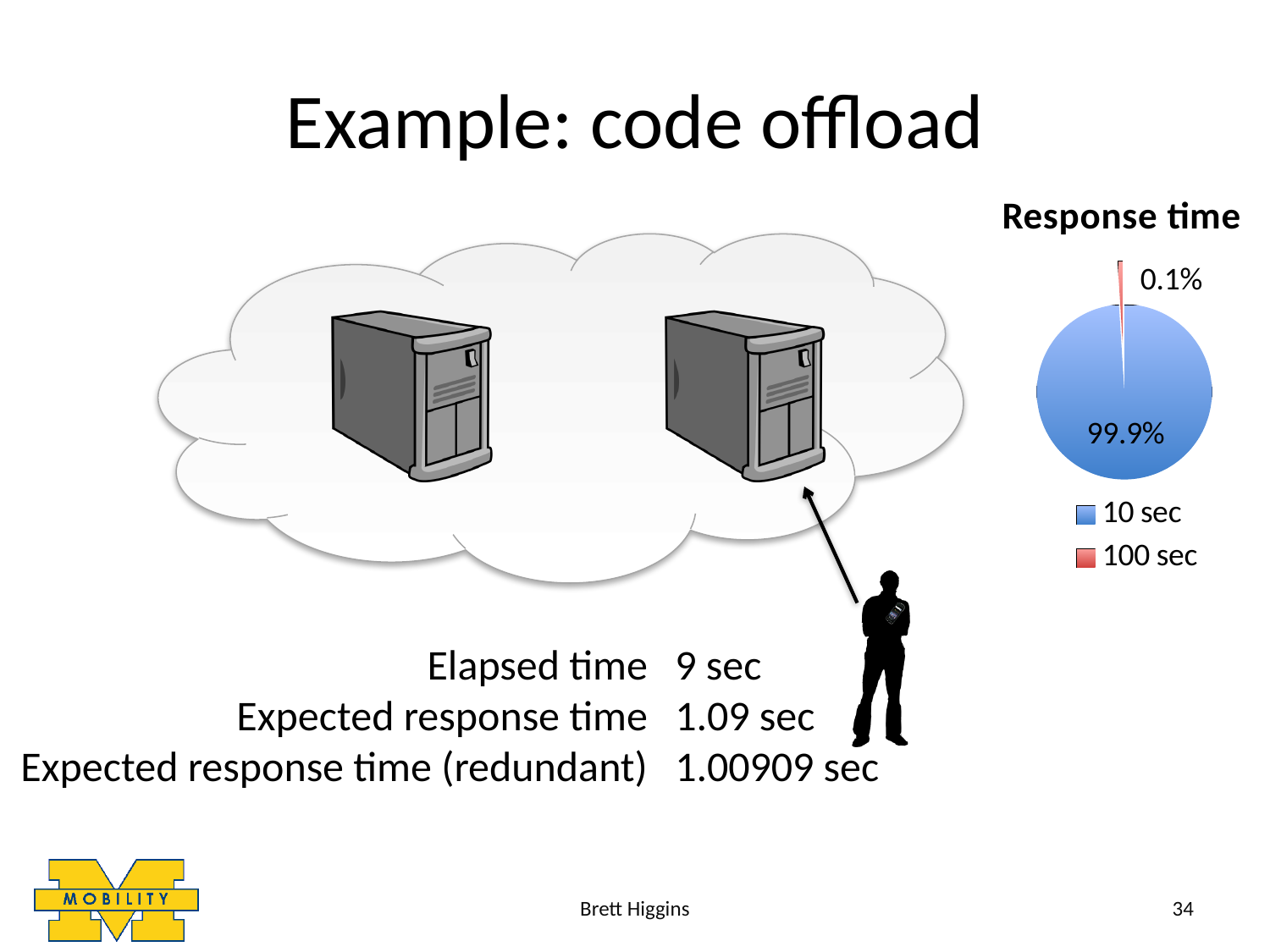
What share of the "Response time" pie is the 10 sec slice? 99.9% Which slice of the "Response time" pie is the largest? 10 sec How many entries does the legend of the "Response time" chart list? 2 What is the difference in share between the 10 sec and 100 sec slices of the "Response time" pie? 99.8% Which slice of the "Response time" pie is the smallest? 100 sec How many slices does the "Response time" pie chart have? 2 In the "Response time" chart, which slice is larger: 10 sec or 100 sec? 10 sec What share of the "Response time" pie is the 100 sec slice? 0.1% What colour is the 100 sec slice in the "Response time" chart? red What is the title of the chart on the slide? Response time What kind of chart is the "Response time" chart? pie chart